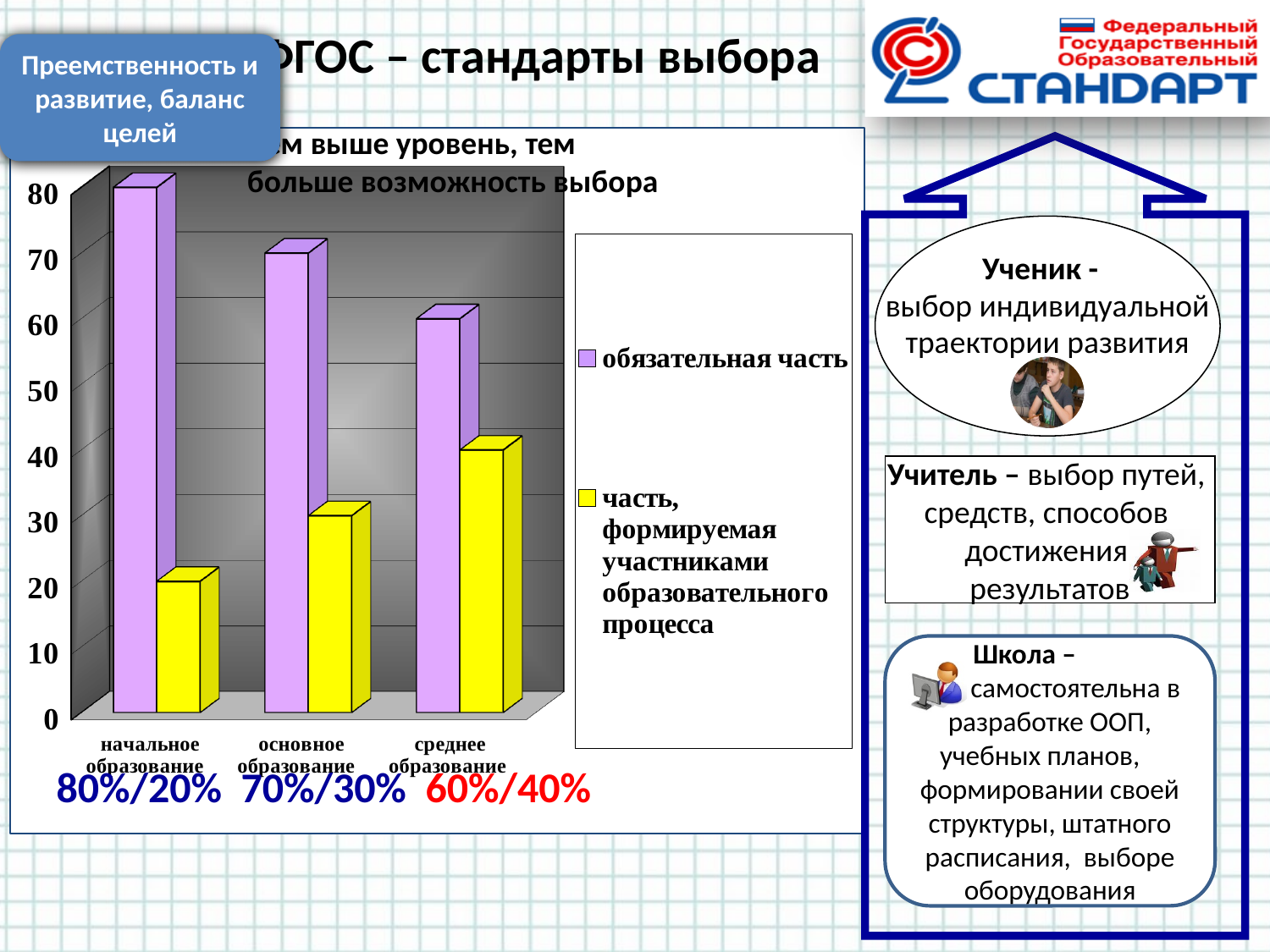
For основное образование, which is larger: обязательная часть or часть, формируемая участниками образовательного процесса? обязательная часть What kind of chart is shown on the slide? bar chart What is the difference between обязательная часть and часть, формируемая участниками образовательного процесса for начальное образование? 60% What is the value of часть, формируемая участниками образовательного процесса for основное образование? 30% What is the value of часть, формируемая участниками образовательного процесса for среднее образование? 40% Which education level has the highest value for обязательная часть? начальное образование Does the value of обязательная часть rise or fall from начальное образование to среднее образование? fall Which education level has the lowest value for обязательная часть? среднее образование Which education level has the highest value for часть, формируемая участниками образовательного процесса? среднее образование What is the value of обязательная часть for начальное образование? 80% How many education levels are shown on the x axis of the chart? 3 How many series does the chart legend list? 2